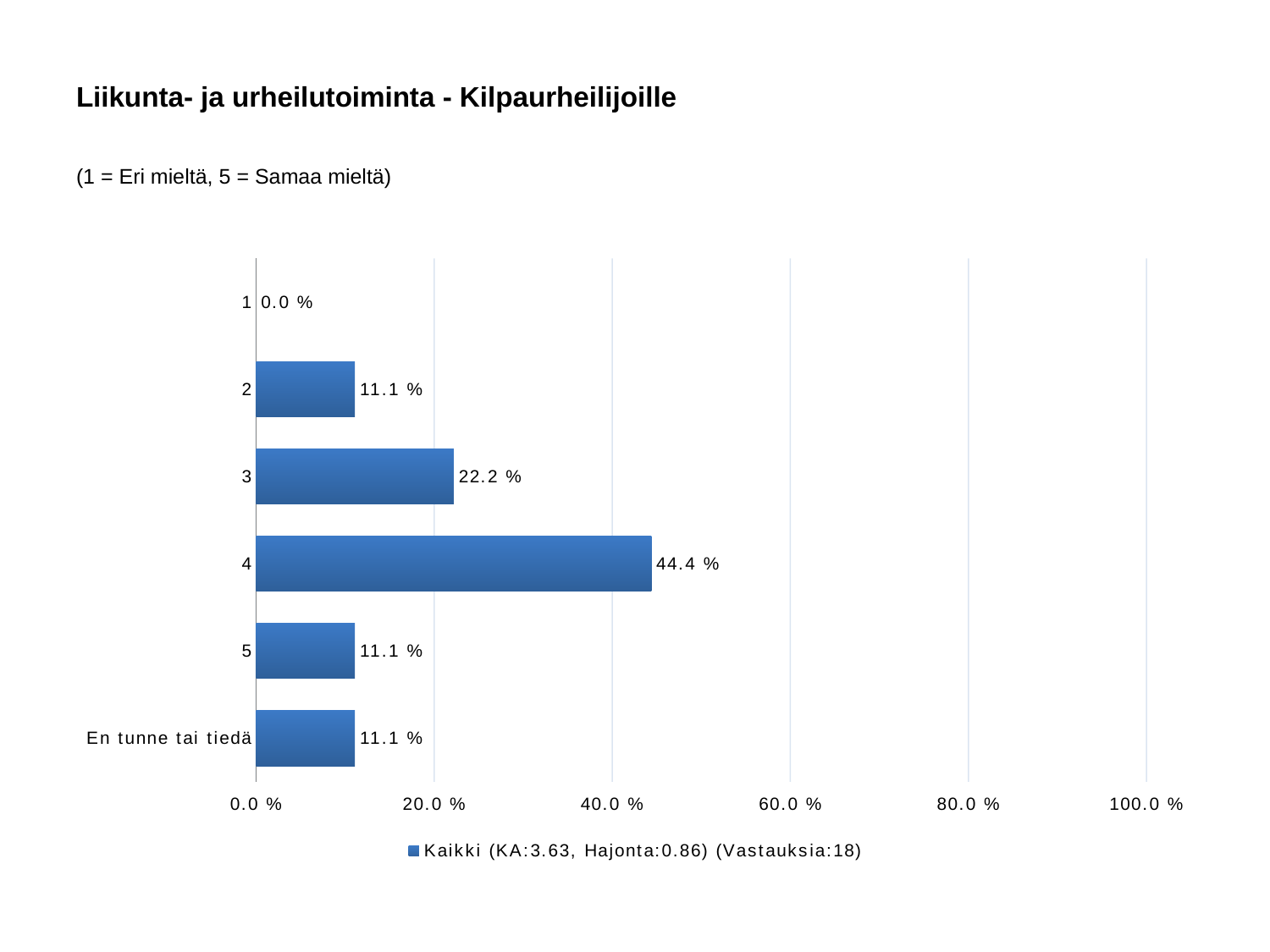
What is the difference between the values for category 4 and category 3? 22.2 % What is the value for "En tunne tai tiedä"? 11.1 % What is the value for category 3? 22.2 % What is the value for category 1? 0.0 % What kind of chart is shown on the slide? bar chart How many categories are shown on the chart? 6 What is the legend entry of the chart? Kaikki (KA:3.63, Hajonta:0.86) (Vastauksia:18) Which is larger, the value for category 3 or the value for category 5? 3 Which category has the lowest value? 1 Is the value for category 4 greater or less than 40.0 %? greater What is the value for category 4? 44.4 % Which category has the highest value? 4